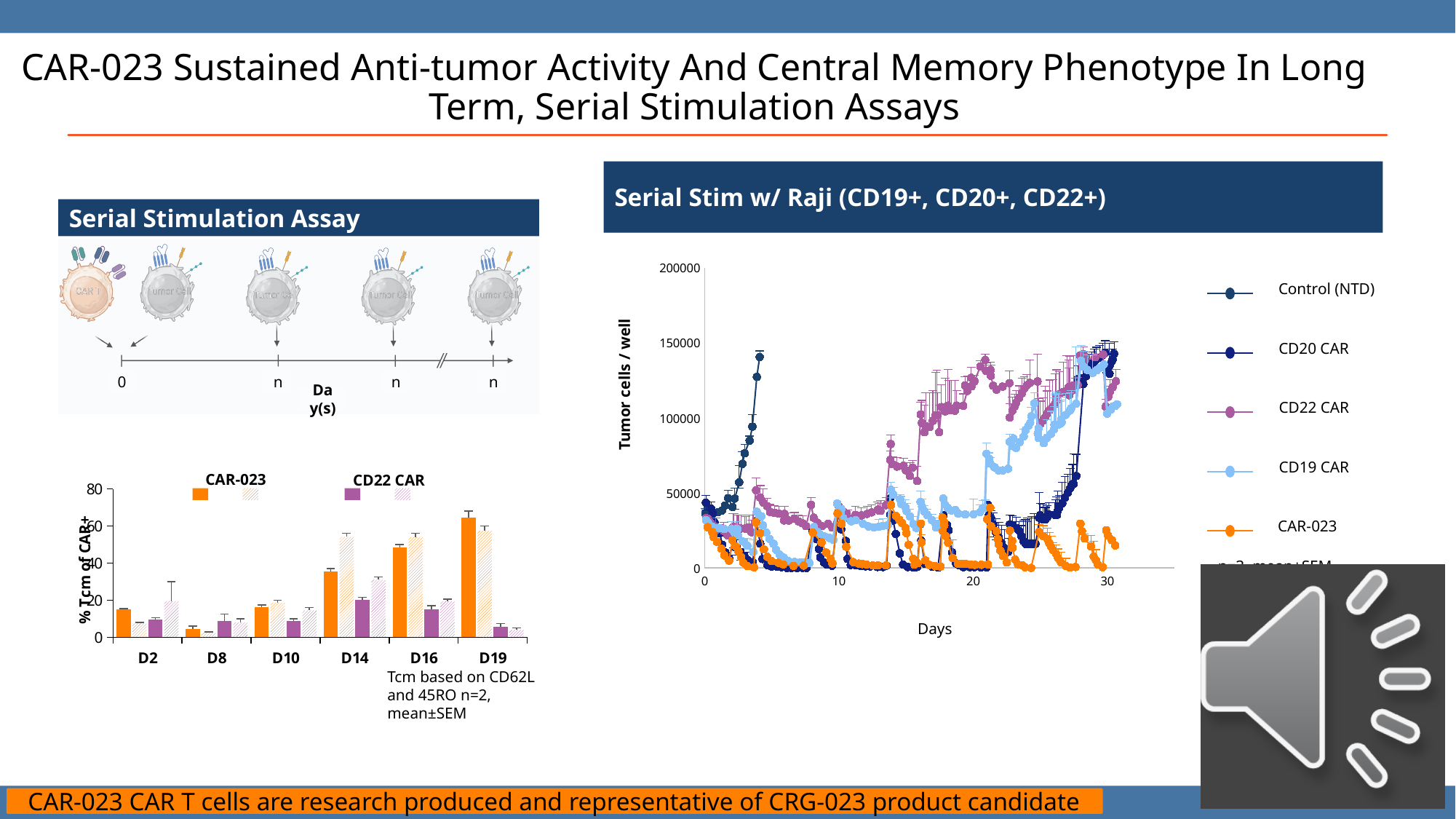
In the Serial Stim w/ Raji chart, what is the y-axis label? Tumor cells / well What kind of chart is the chart on the left showing % Tcm of CAR+? bar chart In the % Tcm of CAR+ bar chart, is the solid CAR-023 bar at D19 greater or less than 40? greater In the % Tcm of CAR+ bar chart, do the solid CAR-023 bars rise or fall from D10 to D19? rise What kind of chart is the Serial Stim w/ Raji chart? line chart In the % Tcm of CAR+ bar chart, how many day categories are shown on the x axis? 6 In the Serial Stim w/ Raji chart, how many series does the legend list? 5 In the % Tcm of CAR+ bar chart, at D19, which solid bar is larger: CAR-023 or CD22 CAR? CAR-023 In the Serial Stim w/ Raji chart, is the peak value for Control (NTD) around day 4 greater or less than 100000? greater In the % Tcm of CAR+ bar chart, at which day is the solid CAR-023 bar highest? D19 In the % Tcm of CAR+ bar chart, is the solid CAR-023 bar at D2 greater or less than 20? less